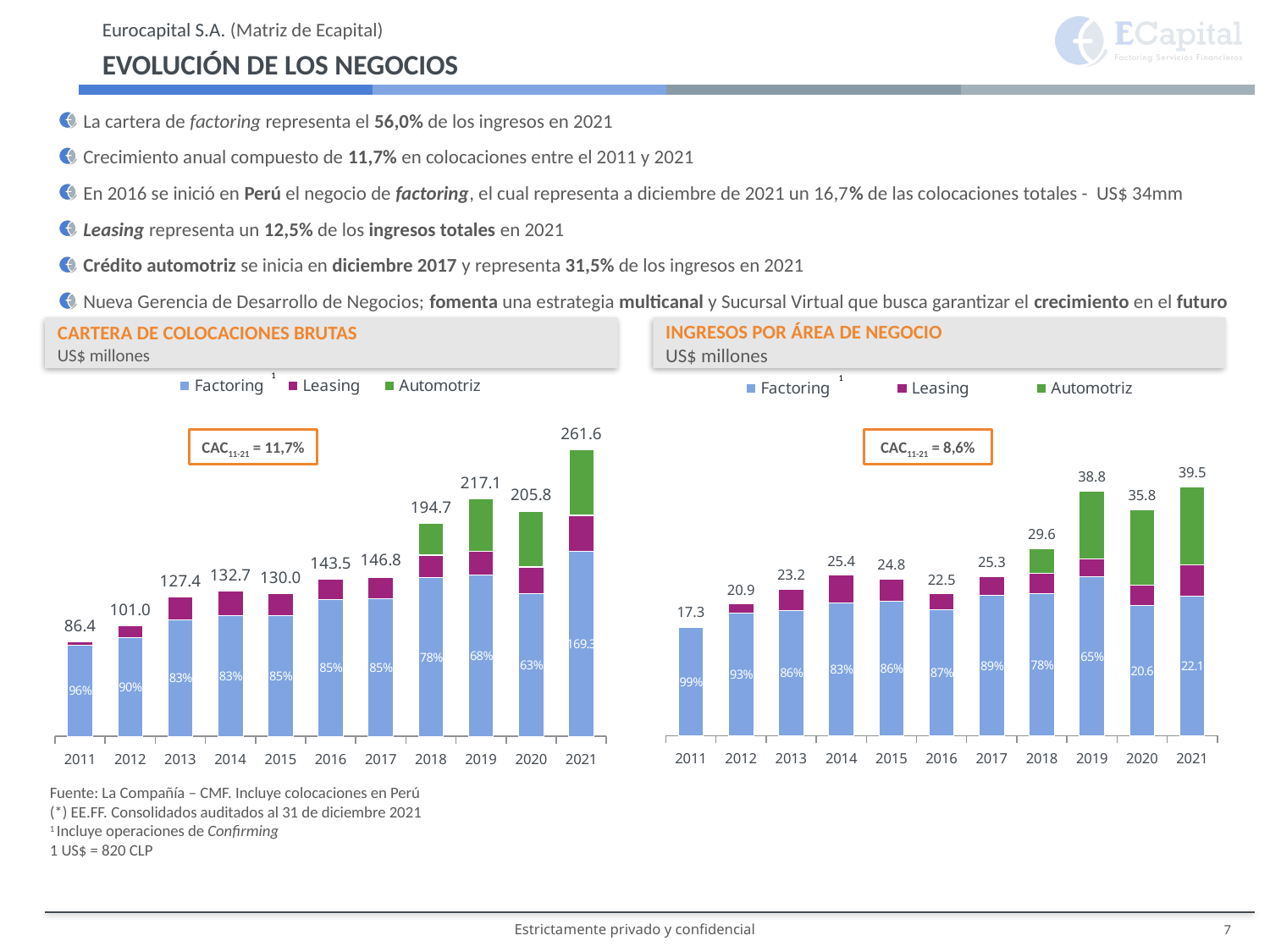
In the 'CARTERA DE COLOCACIONES BRUTAS' chart, what percentage label is shown on the Factoring segment for 2011? 96% In the 'INGRESOS POR ÁREA DE NEGOCIO' chart, what is the difference between the 2021 total and the 2011 total? 22.2 In the 'CARTERA DE COLOCACIONES BRUTAS' chart, what is the total value shown for 2018? 194.7 In the 'CARTERA DE COLOCACIONES BRUTAS' chart, how many series does the legend list? 3 What type of chart is the 'INGRESOS POR ÁREA DE NEGOCIO' chart? Stacked bar chart In the 'INGRESOS POR ÁREA DE NEGOCIO' chart, is the total for 2015 or 2016 larger? 2015 In the 'CARTERA DE COLOCACIONES BRUTAS' chart, what is the difference between the 2021 total and the 2020 total? 55.8 In the 'CARTERA DE COLOCACIONES BRUTAS' chart, which year has the lowest total? 2011 In the 'CARTERA DE COLOCACIONES BRUTAS' chart, what is the total value shown for 2021? 261.6 In the 'INGRESOS POR ÁREA DE NEGOCIO' chart, what is the total value shown for 2019? 38.8 In the 'INGRESOS POR ÁREA DE NEGOCIO' chart, which year has the highest total? 2021 In the 'INGRESOS POR ÁREA DE NEGOCIO' chart, how many years are shown on the x axis? 11